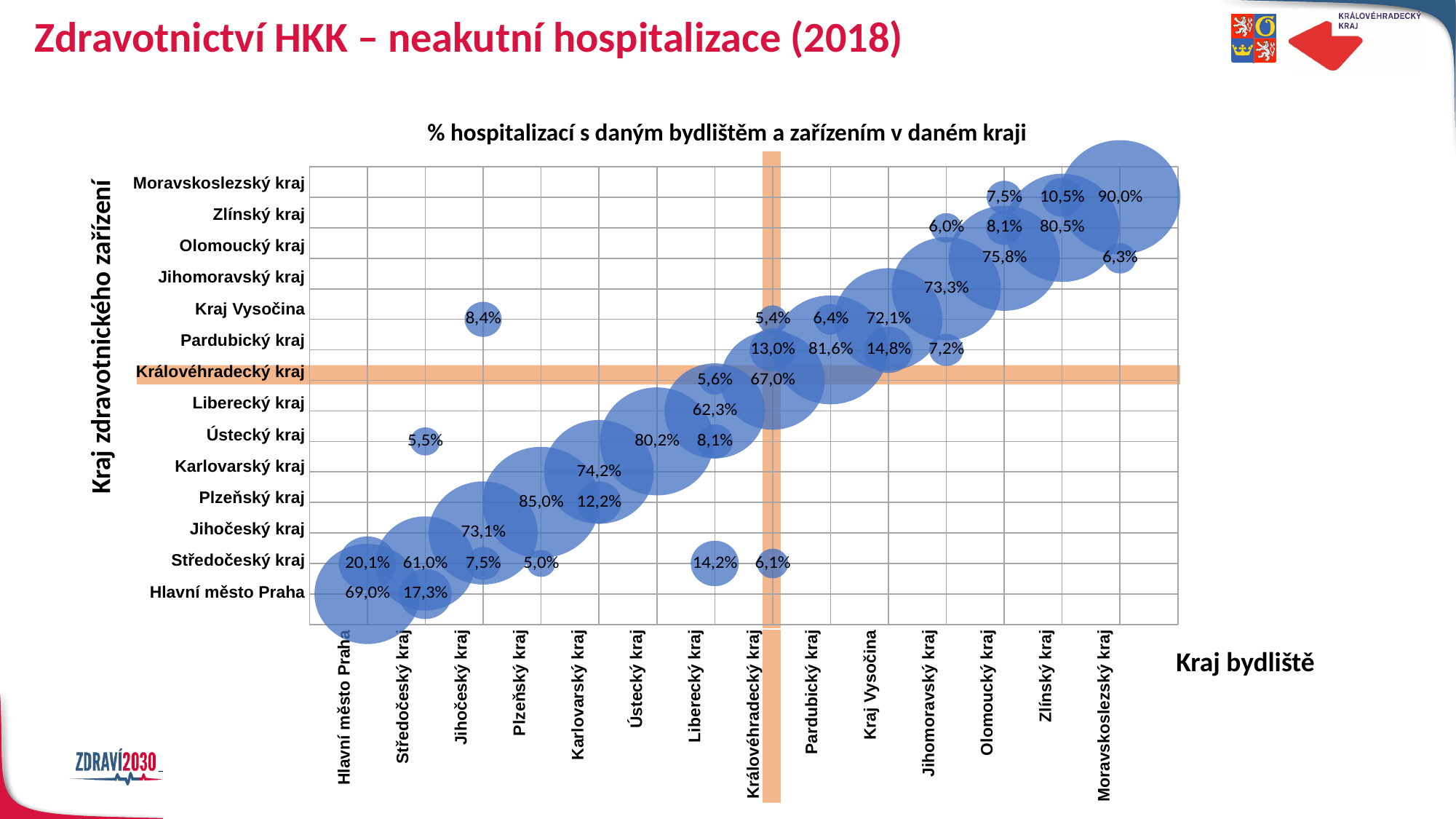
What percentage is shown for residents of Královéhradecký kraj hospitalized in a facility in Královéhradecký kraj? 67,0% What percentage is shown for residents of Hlavní město Praha hospitalized in a facility in Hlavní město Praha? 69,0% Which region of residence has the highest labelled percentage in the chart? Moravskoslezský kraj (90,0%) How many regions (kraje) are listed along the x axis (Kraj bydliště)? 14 What percentage is shown for residents of Pardubický kraj hospitalized in a facility in Pardubický kraj? 81,6% Which is larger: the share of Plzeňský kraj residents treated in Plzeňský kraj, or the share of Hlavní město Praha residents treated in Hlavní město Praha? Plzeňský kraj (85,0%) What is the title of the chart? % hospitalizací s daným bydlištěm a zařízením v daném kraji What kind of chart is shown on the slide? Bubble chart What is the label of the vertical axis of the chart? Kraj zdravotnického zařízení What is the difference between the highest labelled value (90,0%) and the value for Královéhradecký kraj residents treated in Královéhradecký kraj (67,0%)? 23,0 percentage points What is the smallest percentage labelled in the chart? 5,0% What percentage is shown for residents of Plzeňský kraj hospitalized in a facility in Plzeňský kraj? 85,0%